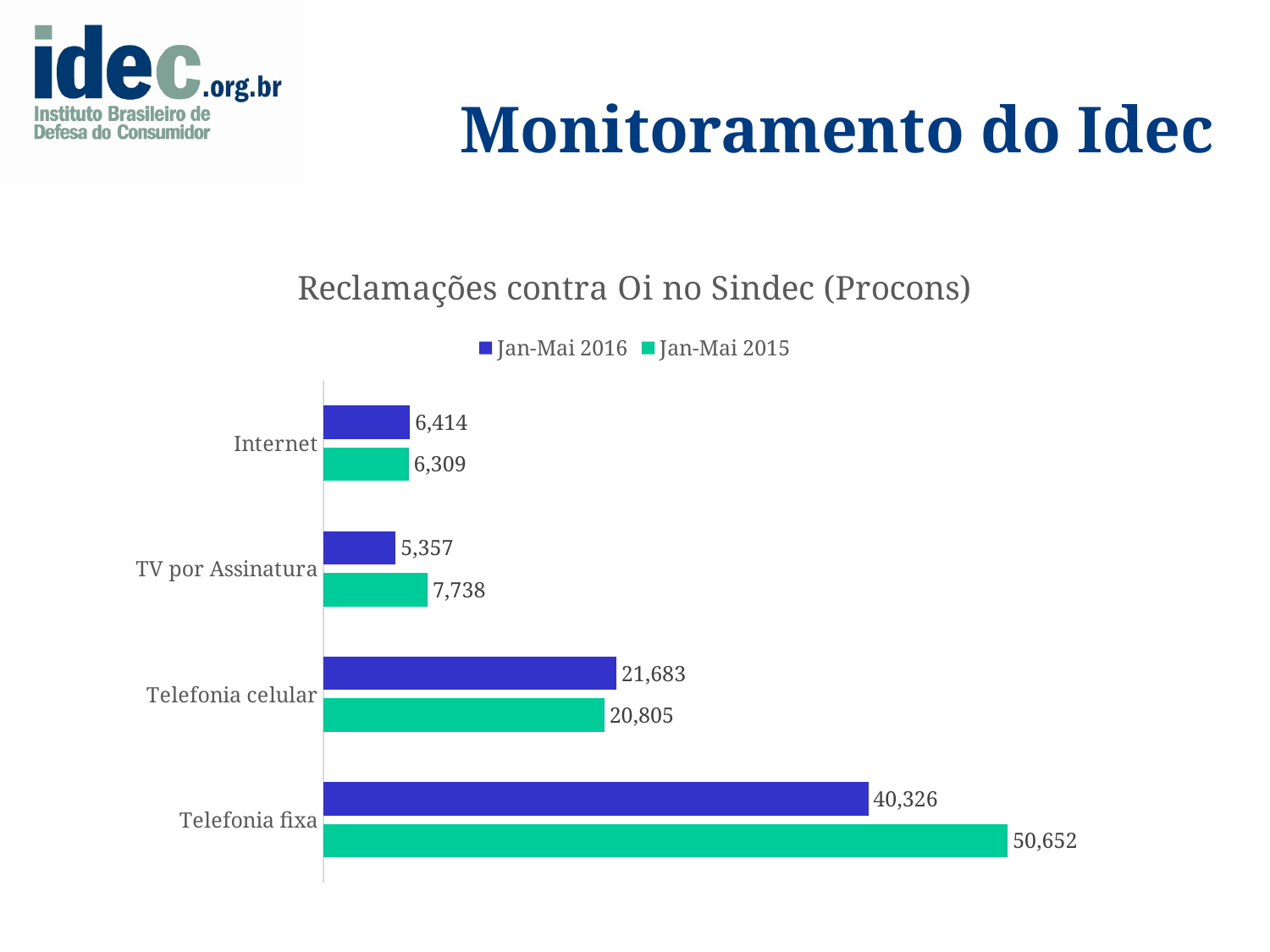
What is the value for TV por Assinatura in the Jan-Mai 2015 series? 7,738 What is the title of the chart? Reclamações contra Oi no Sindec (Procons) For TV por Assinatura, which series has the larger value, Jan-Mai 2016 or Jan-Mai 2015? Jan-Mai 2015 Which category has the lowest value in the Jan-Mai 2016 series? TV por Assinatura What is the difference between the Jan-Mai 2016 and Jan-Mai 2015 values for Telefonia celular? 878 How many series does the legend list? 2 Which category has the highest value in the Jan-Mai 2015 series? Telefonia fixa What kind of chart is shown on the slide? Bar chart What is the value for Telefonia fixa in the Jan-Mai 2016 series? 40,326 What is the difference between the Jan-Mai 2015 and Jan-Mai 2016 values for Telefonia fixa? 10,326 What is the value for Internet in the Jan-Mai 2016 series? 6,414 How many categories are shown in the chart? 4